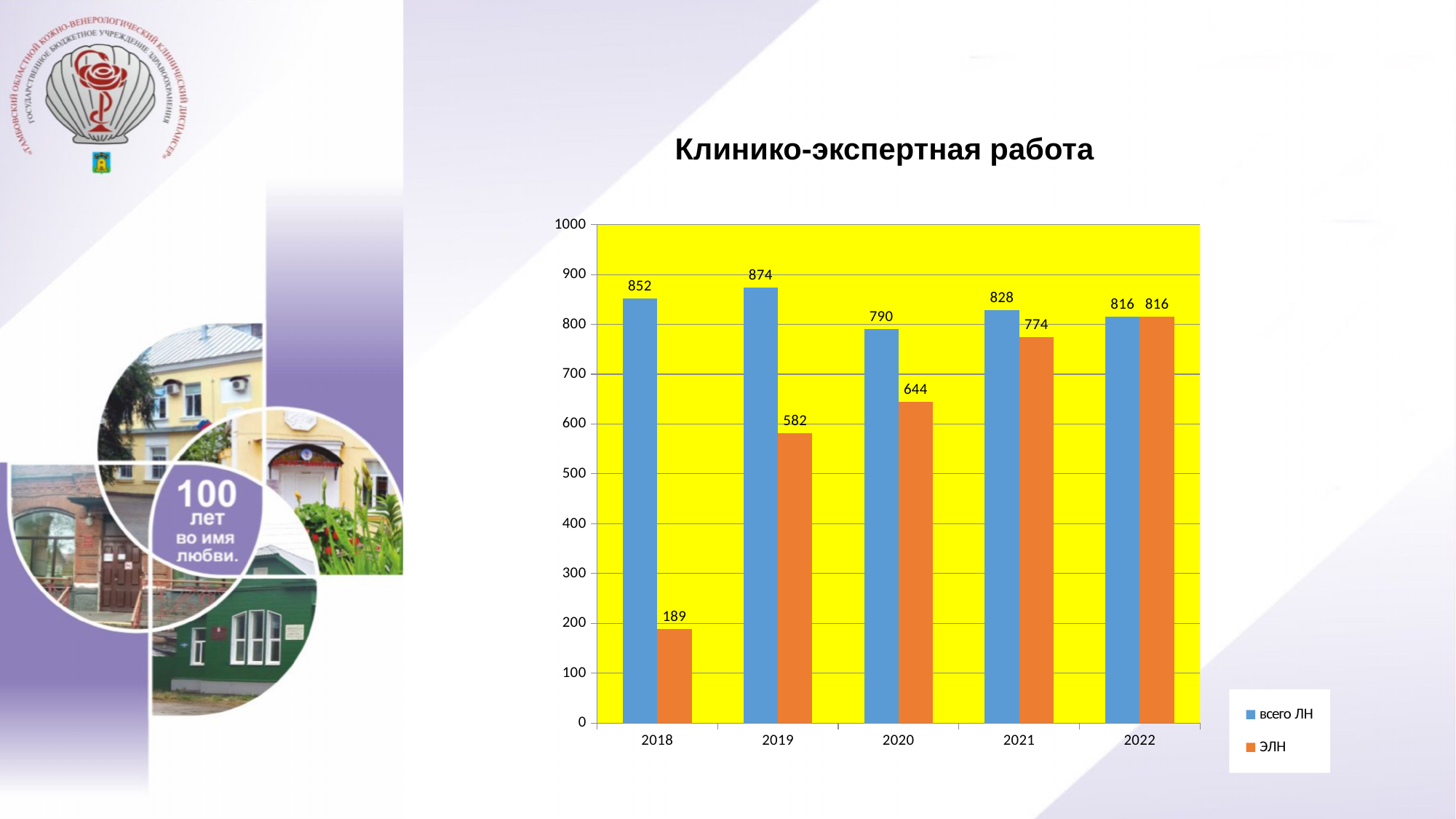
What is the value of всего ЛН for 2018? 852 How many years are shown on the x axis? 5 Which is larger: всего ЛН in 2020 or всего ЛН in 2021? всего ЛН in 2021 What is the value of ЭЛН for 2022? 816 How many series does the legend list? 2 What is the value of ЭЛН for 2020? 644 Does ЭЛН rise or fall from 2018 to 2022? rise What is the difference between всего ЛН and ЭЛН in 2021? 54 What kind of chart is shown on the slide? bar chart In which year is всего ЛН highest? 2019 In which year is ЭЛН lowest? 2018 What is the difference between ЭЛН in 2019 and ЭЛН in 2018? 393